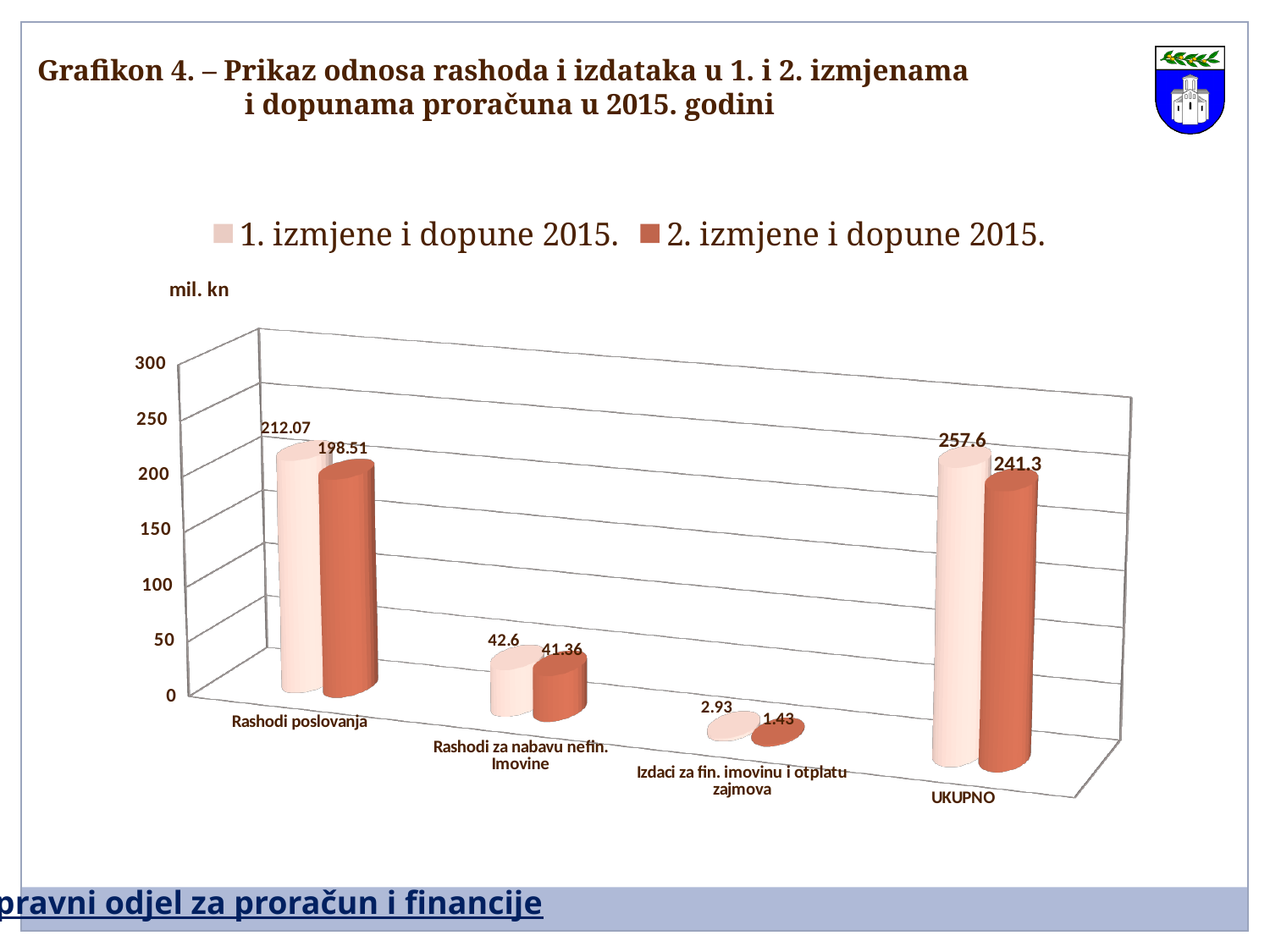
What kind of chart is shown on the slide? Bar chart What is the value for Rashodi poslovanja in the 1. izmjene i dopune 2015. series? 212.07 Which category has the lowest value in the 2. izmjene i dopune 2015. series? Izdaci za fin. imovinu i otplatu zajmova What is the difference between the 1. izmjene i dopune 2015. and 2. izmjene i dopune 2015. values for UKUPNO? 16.3 How many series does the legend list? 2 Which category has the highest value in the 1. izmjene i dopune 2015. series? UKUPNO What is the value for Izdaci za fin. imovinu i otplatu zajmova in the 2. izmjene i dopune 2015. series? 1.43 How many categories are shown on the x axis? 4 What unit is shown on the vertical axis label? mil. kn What is the value for UKUPNO in the 2. izmjene i dopune 2015. series? 241.3 Which is larger for Rashodi poslovanja: the 1. izmjene i dopune 2015. value or the 2. izmjene i dopune 2015. value? 1. izmjene i dopune 2015. What is the value for Rashodi za nabavu nefin. imovine in the 1. izmjene i dopune 2015. series? 42.6